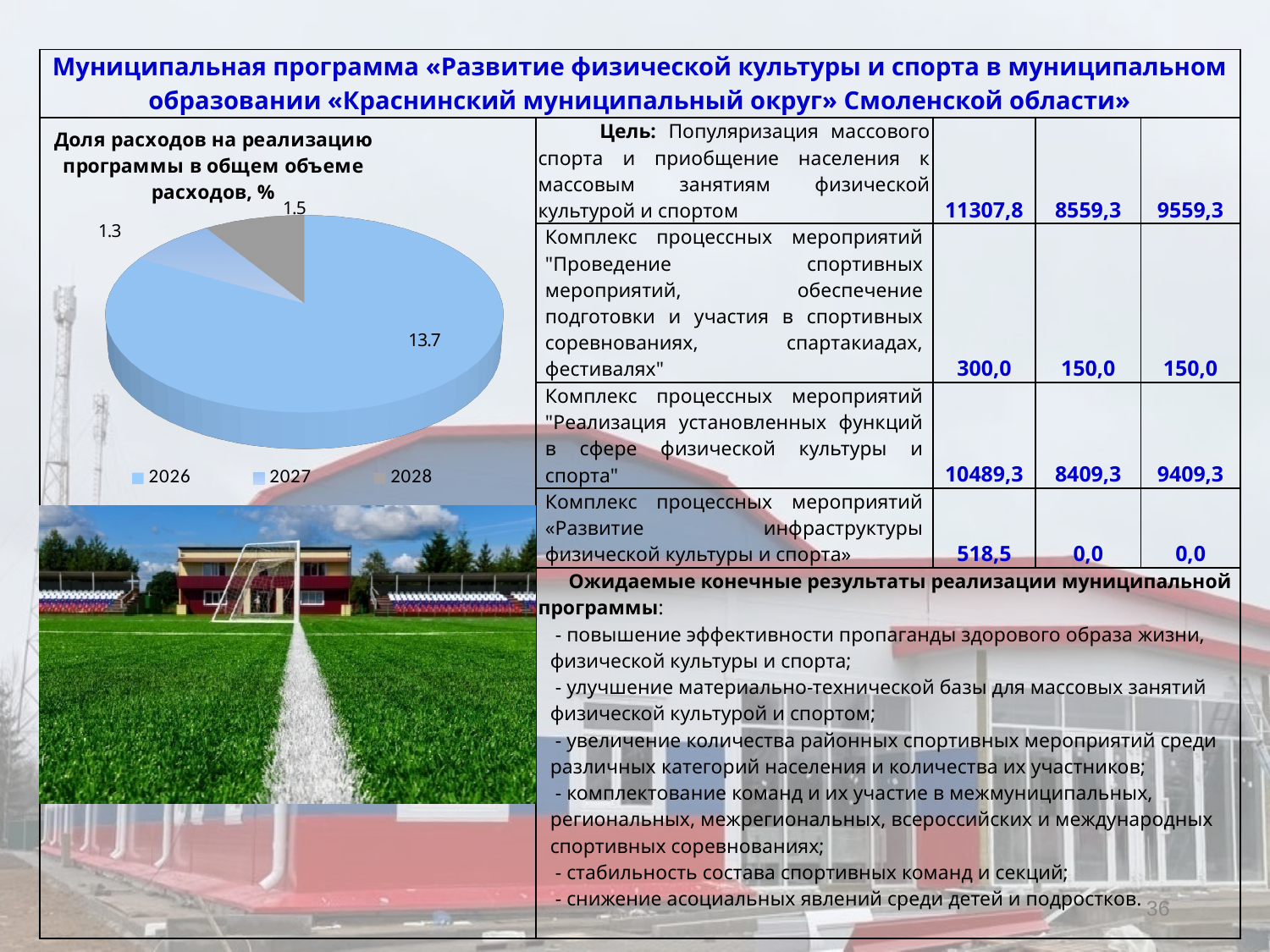
How many years does the legend of the pie chart list? 3 Which years are listed in the legend of the pie chart? 2026, 2027, 2028 What is the value labelled on the largest slice of the pie chart? 13.7 What is the difference between the largest and the smallest values labelled on the pie chart? 12.4 How many slices does the pie chart have? 3 Which is larger in the pie chart, the value for 2026 or the value for 2027? 2026 What is the title of the pie chart? Доля расходов на реализацию программы в общем объеме расходов, % Which year has the largest share in the pie chart? 2026 What type of chart is shown on the slide? pie chart What is the sum of the three values labelled on the pie chart? 16.5 What is the smallest value labelled on the pie chart? 1.3 What is the value for 2026 in the pie chart? 13.7